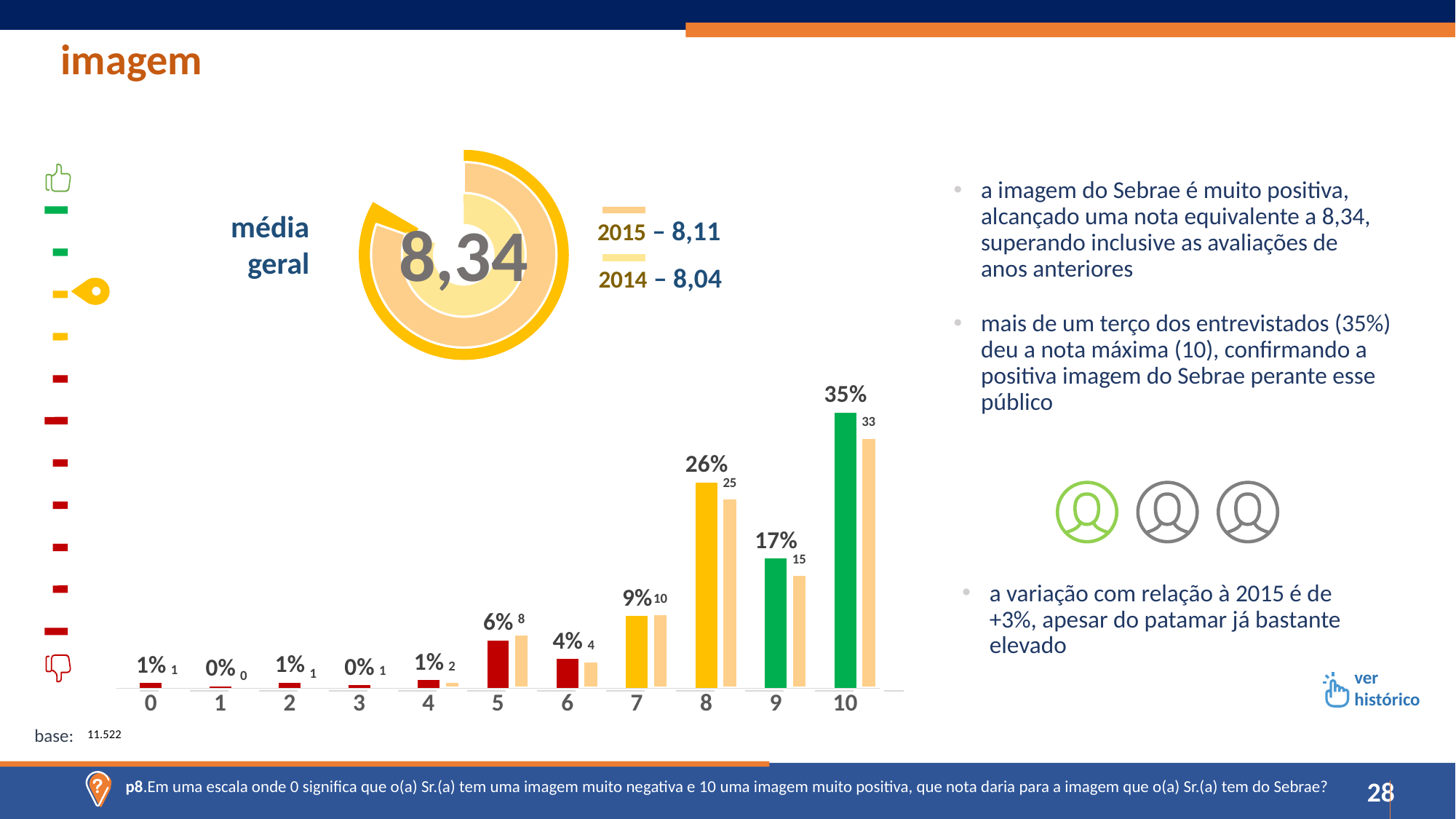
In the bar chart of score distribution, which has a larger percentage, score 8 or score 9? 8 In the bar chart of score distribution, which score has the highest percentage? 10 In the bar chart of score distribution, what is the small previous-year value printed next to the bar for score 10? 33 In the bar chart of score distribution, what is the difference between the percentages for score 10 and score 9? 18% In the bar chart of score distribution, what is the small previous-year value printed next to the bar for score 8? 25 In the circular 'média geral' chart, what average is shown for 2015? 8,11 In the bar chart of score distribution, what percentage of respondents gave a score of 8? 26% In the circular 'média geral' chart, what is the overall average score shown in the centre? 8,34 What kind of chart is used to show the distribution of scores from 0 to 10? bar chart In the bar chart of score distribution, how many score categories are shown on the x axis? 11 In the bar chart of score distribution, what percentage of respondents gave a score of 10? 35% In the bar chart of score distribution, what percentage of respondents gave a score of 5? 6%